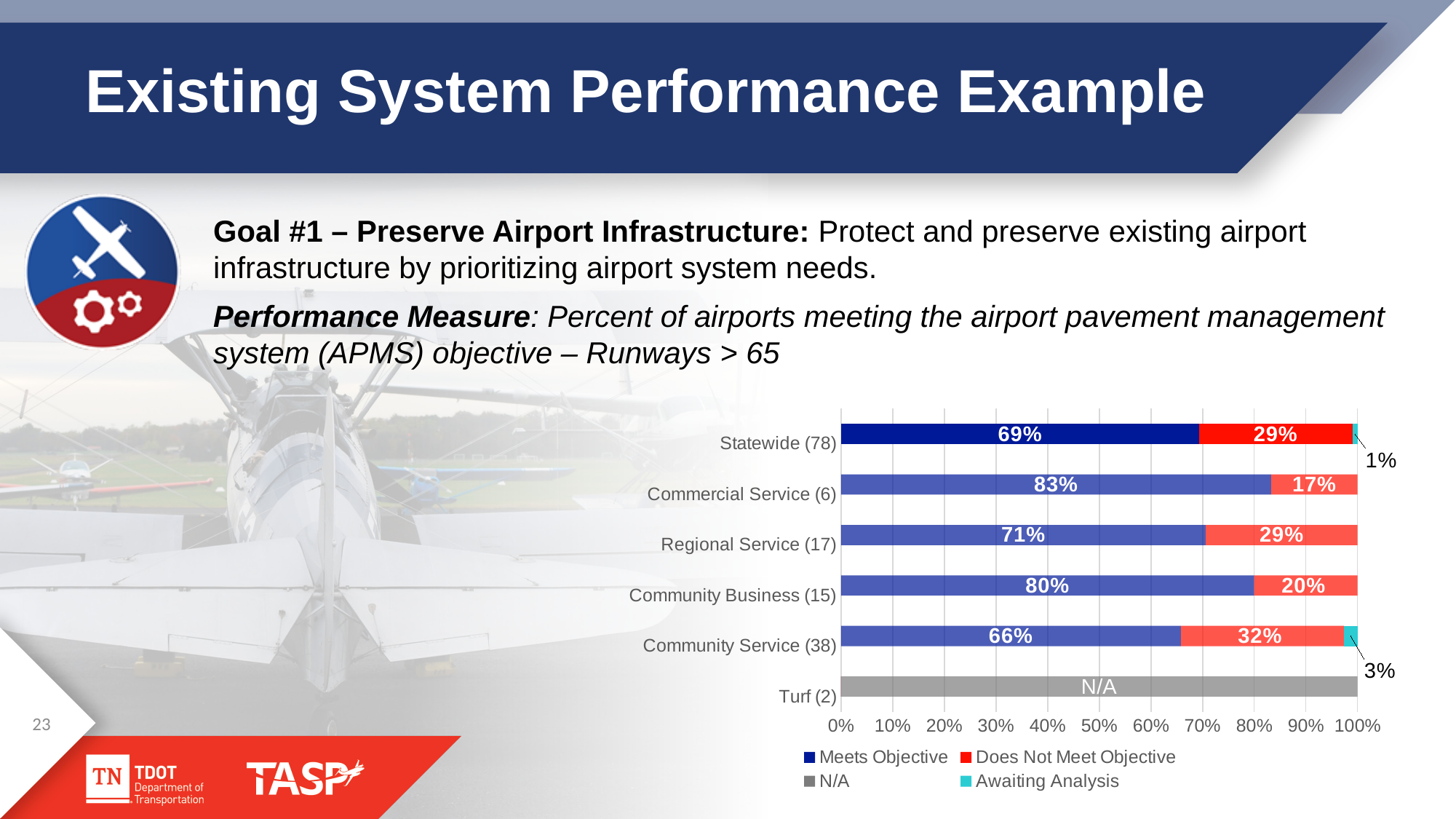
What is the Does Not Meet Objective value for Community Service (38)? 32% How many categories are shown on the chart? 6 What value is shown for the Turf (2) category? N/A What is the Meets Objective value for Community Business (15)? 80% What percentage of Commercial Service airports meet the objective? 83% Among the categories with percentages shown, which has the lowest Meets Objective percentage? Community Service (38) What is the Awaiting Analysis value for Statewide (78)? 1% Which category has the highest Meets Objective percentage? Commercial Service (6) How many series does the legend list? 4 What kind of chart is shown on the slide? Stacked bar chart Which is larger: the Does Not Meet Objective value for Regional Service or for Community Business? Regional Service What is the difference between the Meets Objective percentages for Commercial Service and Regional Service? 12%